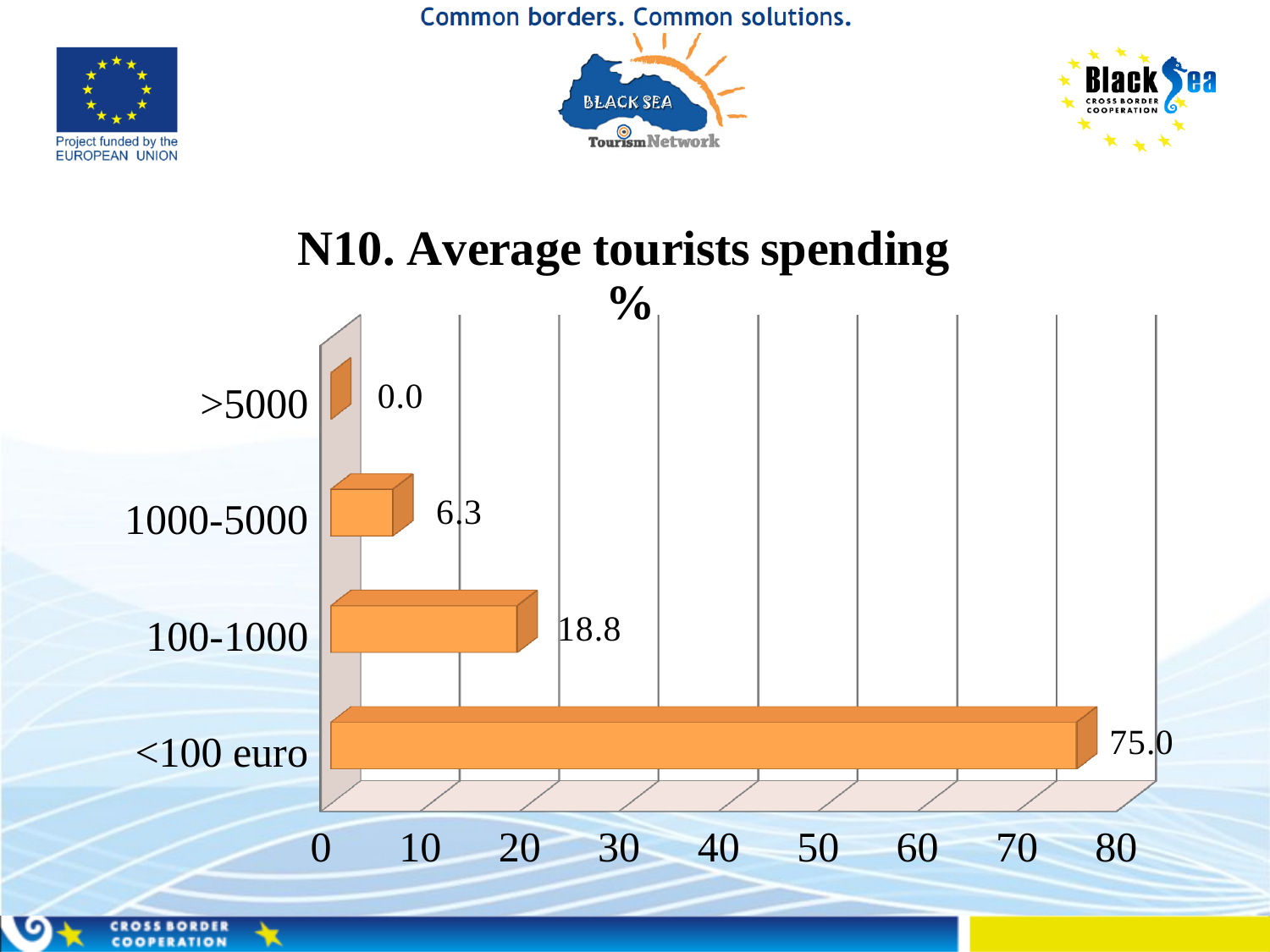
Which category has the lowest value? >5000 What is the difference between the values for 100-1000 and 1000-5000? 12.5 What kind of chart is shown on the slide? Bar chart What is the value for the >5000 category? 0.0 Which is larger, the value for 100-1000 or the value for 1000-5000? 100-1000 What is the value for the <100 euro category? 75.0 Which category has the highest value? <100 euro How many categories are shown in the chart? 4 What is the value for the 1000-5000 category? 6.3 What is the difference between the values for <100 euro and 100-1000? 56.2 What is the value for the 100-1000 category? 18.8 What is the title of the chart? N10. Average tourists spending %